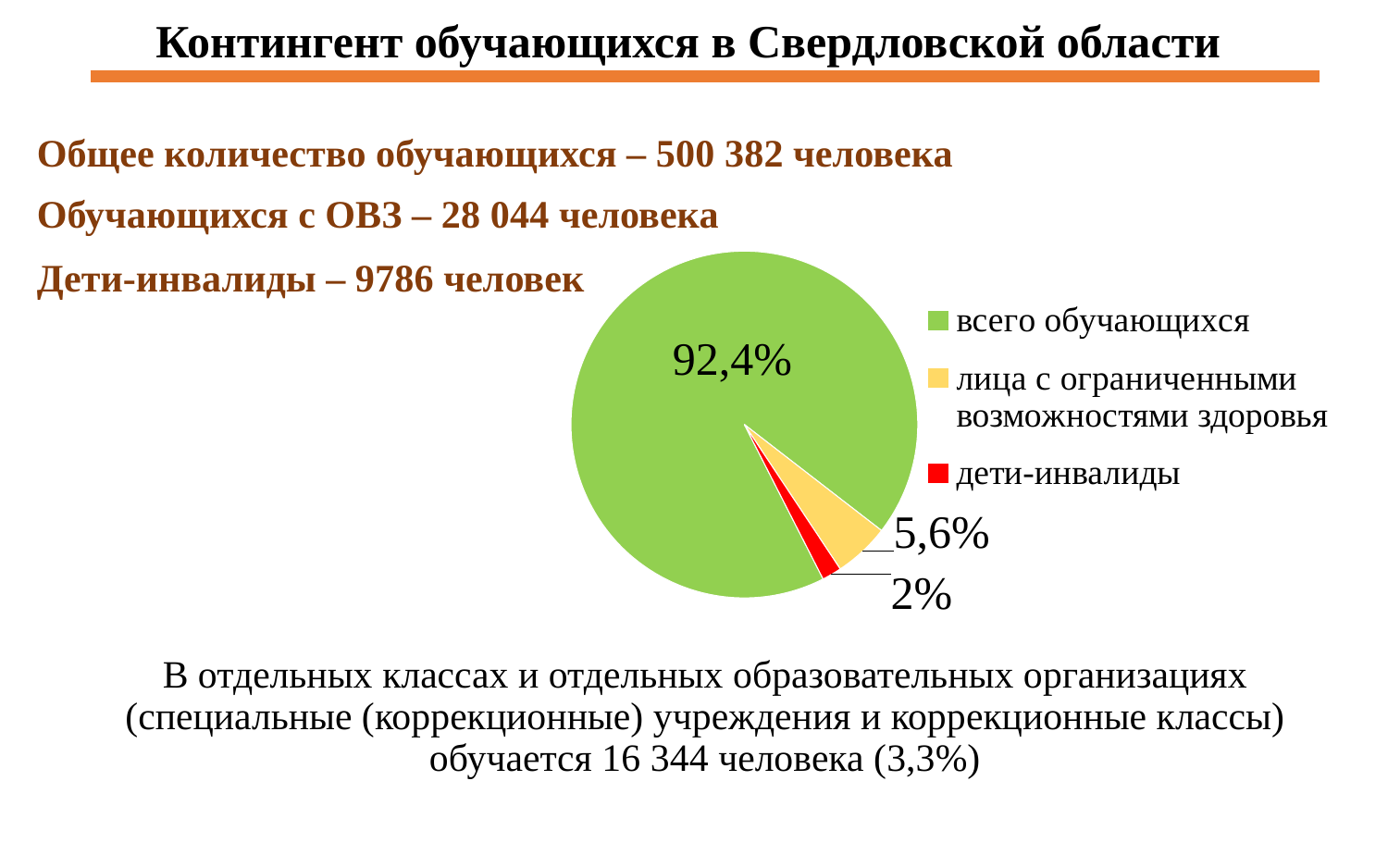
What percentage is shown for the slice "лица с ограниченными возможностями здоровья"? 5,6% What colour is the slice for "всего обучающихся" in the pie chart? green What percentage is shown for the slice "дети-инвалиды"? 2% Which slice of the pie chart is the smallest? дети-инвалиды How many entries does the legend of the pie chart list? 3 What percentage is shown for the slice "всего обучающихся"? 92,4% What is the difference in percentage points between the slices "лица с ограниченными возможностями здоровья" and "дети-инвалиды"? 3,6 How many slices does the pie chart have? 3 What colour is the slice for "дети-инвалиды" in the pie chart? red Which slice of the pie chart is the largest? всего обучающихся Which slice is larger: "лица с ограниченными возможностями здоровья" or "дети-инвалиды"? лица с ограниченными возможностями здоровья What kind of chart is shown on the slide? pie chart